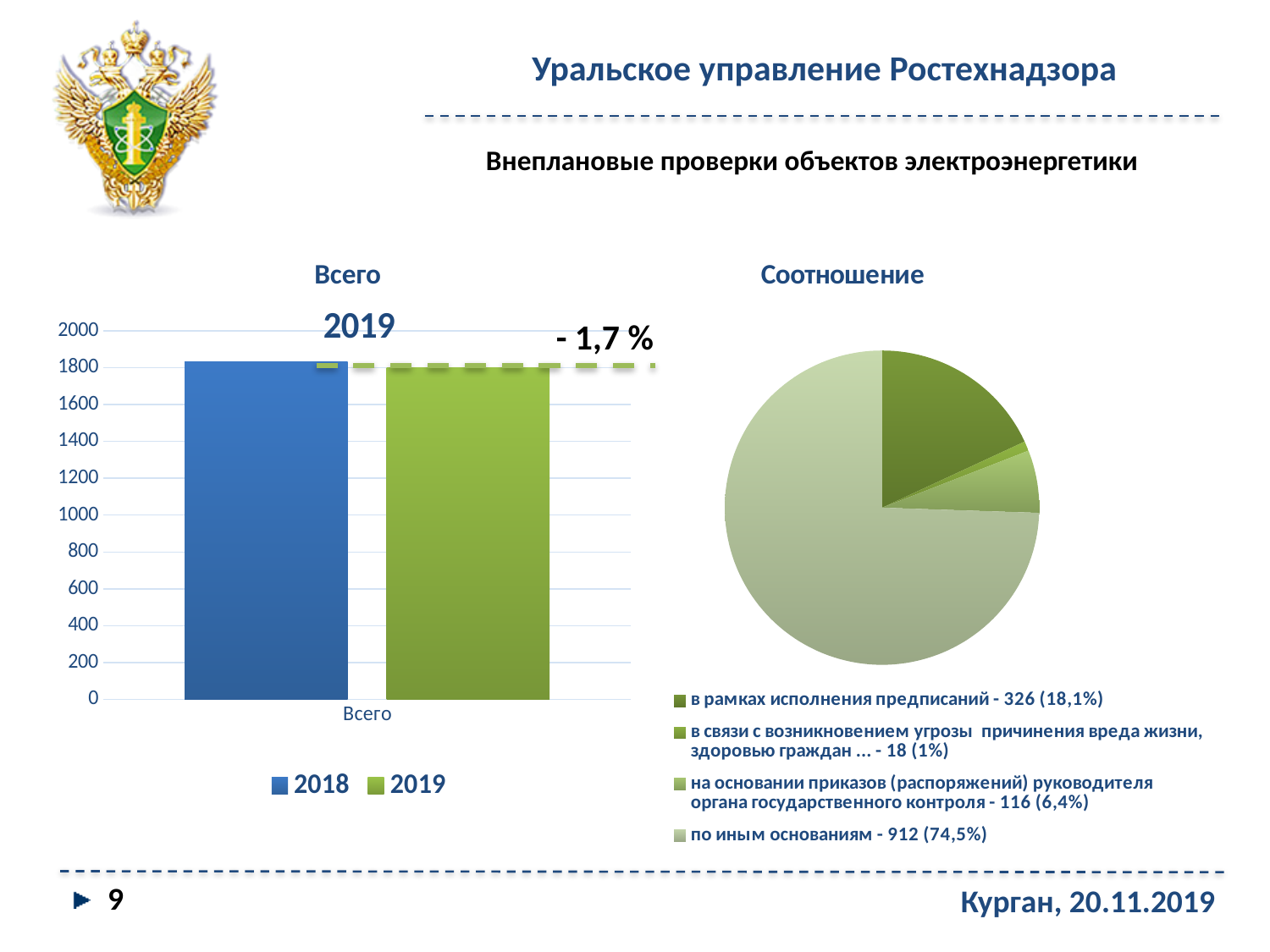
In the "Всего" bar chart, is the value for 2018 greater or less than 1600? greater What kind of chart is the chart titled "Соотношение" on the right of the slide? pie chart In the "Всего" bar chart, what percentage change from 2018 to 2019 is annotated on the chart? - 1,7 % What kind of chart is the chart titled "Всего" on the left of the slide? bar chart In the "Всего" bar chart, is the value for 2019 greater or less than 1400? greater In the "Всего" bar chart, how many series does the legend list? 2 In the "Соотношение" pie chart, what share of the pie does "по иным основаниям" take? 74,5% In the "Соотношение" pie chart, which category has the largest value? по иным основаниям In the "Соотношение" pie chart, what is the difference between the value for "по иным основаниям" and the value for "в рамках исполнения предписаний"? 586 In the "Соотношение" pie chart, what is the value for "в рамках исполнения предписаний"? 326 (18,1%) In the "Соотношение" pie chart, how many categories does the legend list? 4 In the "Соотношение" pie chart, which category has the smallest value? в связи с возникновением угрозы причинения вреда жизни, здоровью граждан …